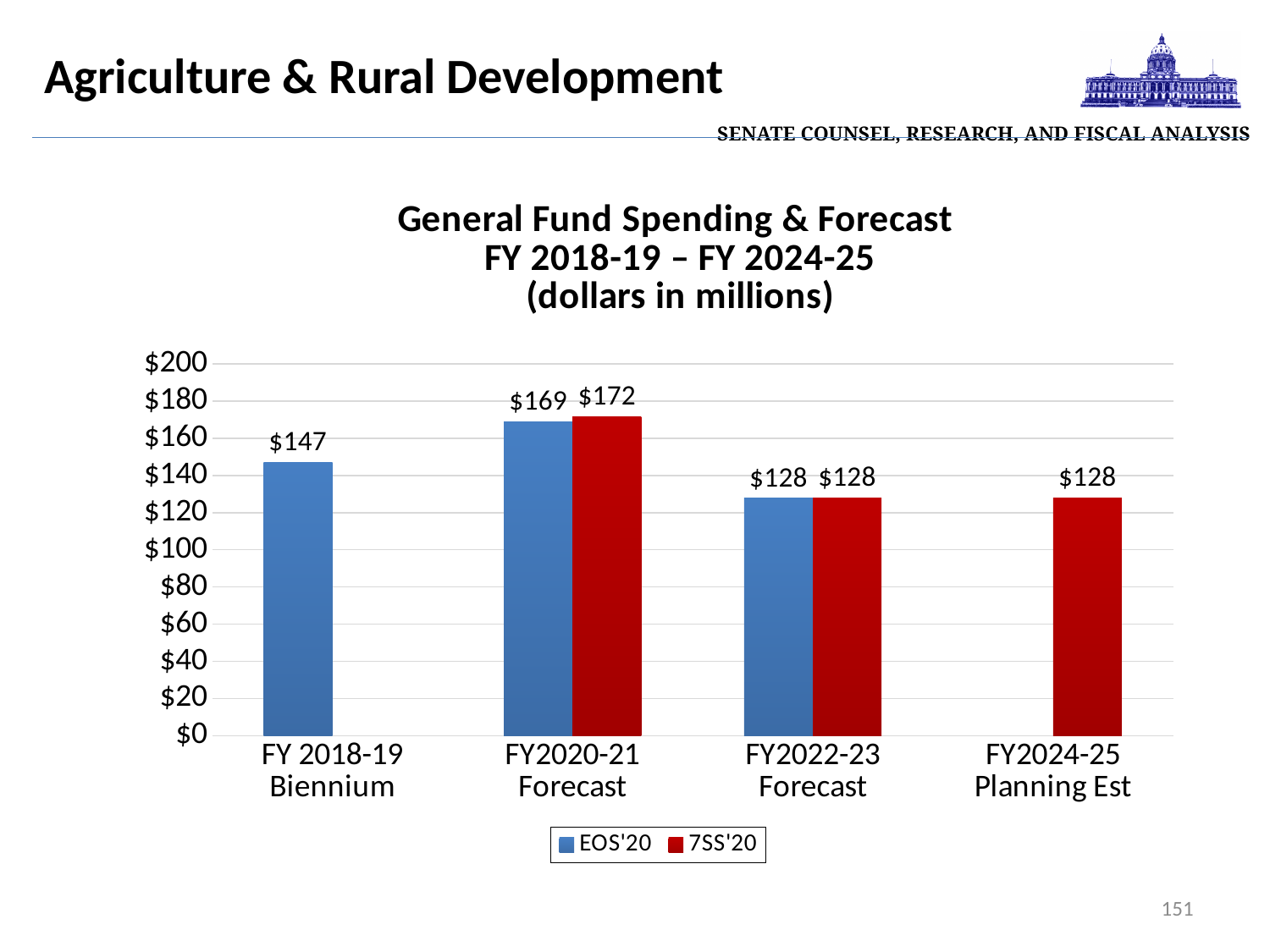
What is the EOS'20 value for FY 2018-19 Biennium? $147 What is the 7SS'20 value for FY2020-21 Forecast? $172 How many series does the legend list? 2 Which is larger for FY2020-21 Forecast, the EOS'20 value or the 7SS'20 value? 7SS'20 How many categories are shown on the x axis? 4 What kind of chart is shown on the slide? Bar chart What is the EOS'20 value for FY2022-23 Forecast? $128 What is the difference between the 7SS'20 and EOS'20 values for FY2020-21 Forecast? $3 Which category has the highest EOS'20 value? FY2020-21 Forecast Which category has the lowest EOS'20 value? FY2022-23 Forecast What colour are the 7SS'20 bars? Red What is the 7SS'20 value for FY2024-25 Planning Est? $128